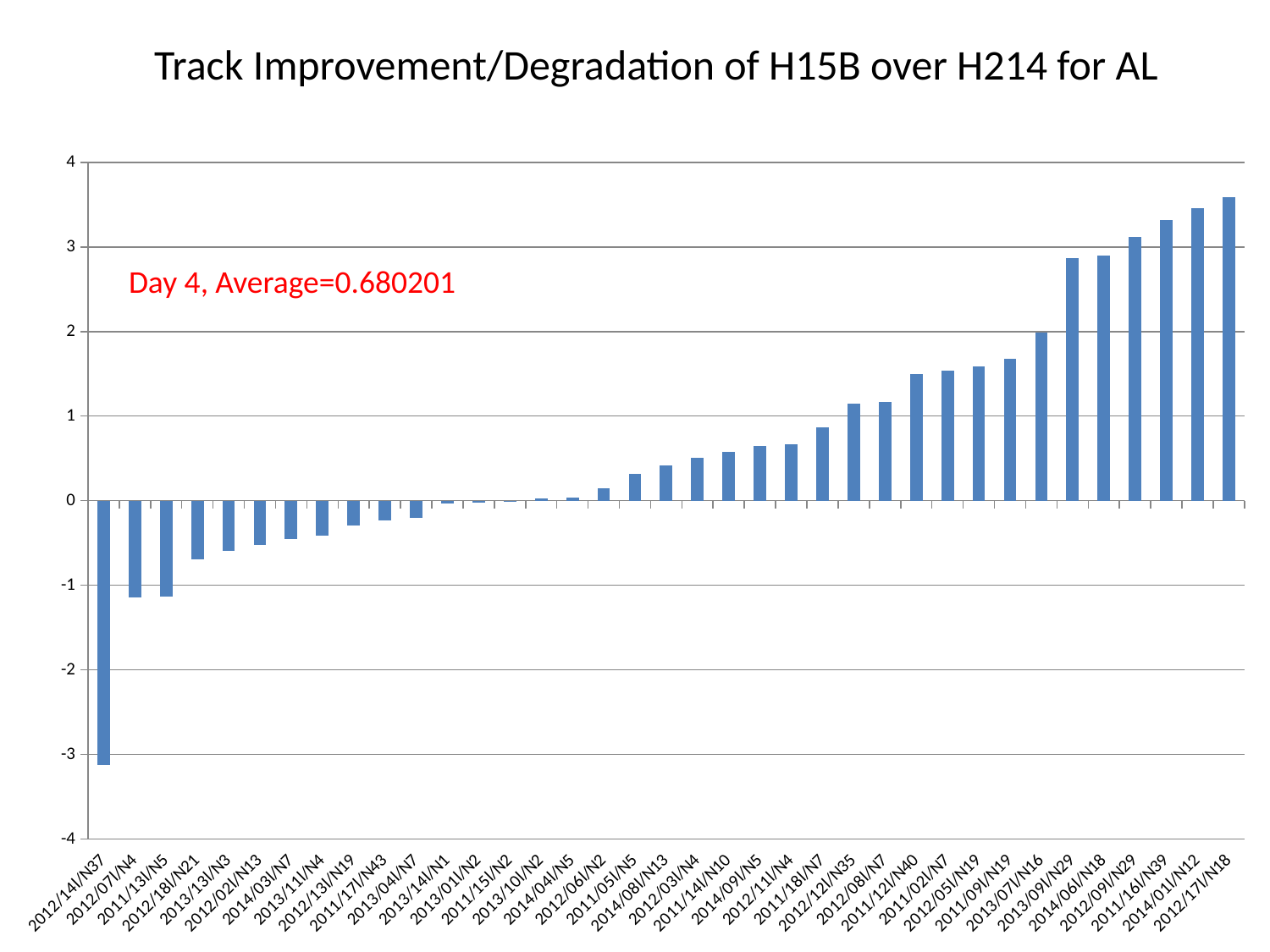
What is the title of the chart? Track Improvement/Degradation of H15B over H214 for AL Which has the larger value, 2012/14l/N37 or 2012/17l/N18? 2012/17l/N18 What kind of chart is shown on the slide? bar chart What does the red annotation on the chart say? Day 4, Average=0.680201 Do the bar values rise or fall from left to right along the x axis? rise Is the value for 2012/14l/N37 greater or less than -3? less Which category has the highest value? 2012/17l/N18 Is the value for 2012/07l/N4 greater or less than -1? less How many categories are plotted on the x axis? 37 Is the value for 2012/17l/N18 greater or less than 3? greater Which category has the lowest value? 2012/14l/N37